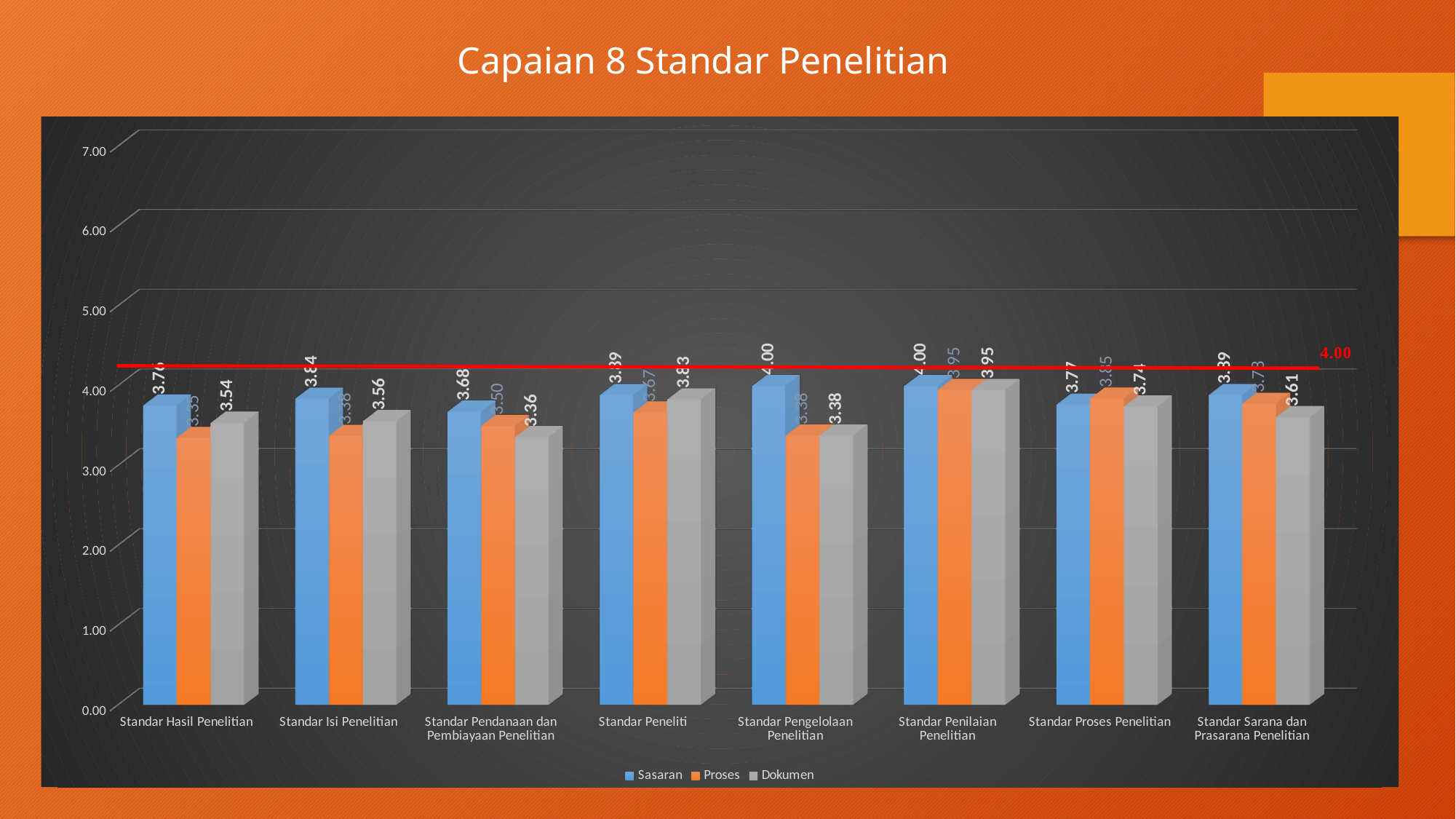
What is the Proses value for Standar Proses Penelitian? 3.85 What kind of chart is shown on the slide? bar chart What is the Dokumen value for Standar Peneliti? 3.83 How many standards (categories) are shown on the x axis? 8 Which standard has the highest Dokumen value? Standar Penilaian Penelitian What is the difference between the Sasaran and Dokumen values for Standar Sarana dan Prasarana Penelitian? 0.28 What is the Sasaran value for Standar Isi Penelitian? 3.84 For Standar Proses Penelitian, which is larger: the Sasaran value or the Proses value? Proses What value does the red horizontal reference line mark? 4.00 What is the Sasaran value for Standar Pengelolaan Penelitian? 4.00 How many series does the legend list? 3 What is the Dokumen value for Standar Pendanaan dan Pembiayaan Penelitian? 3.36